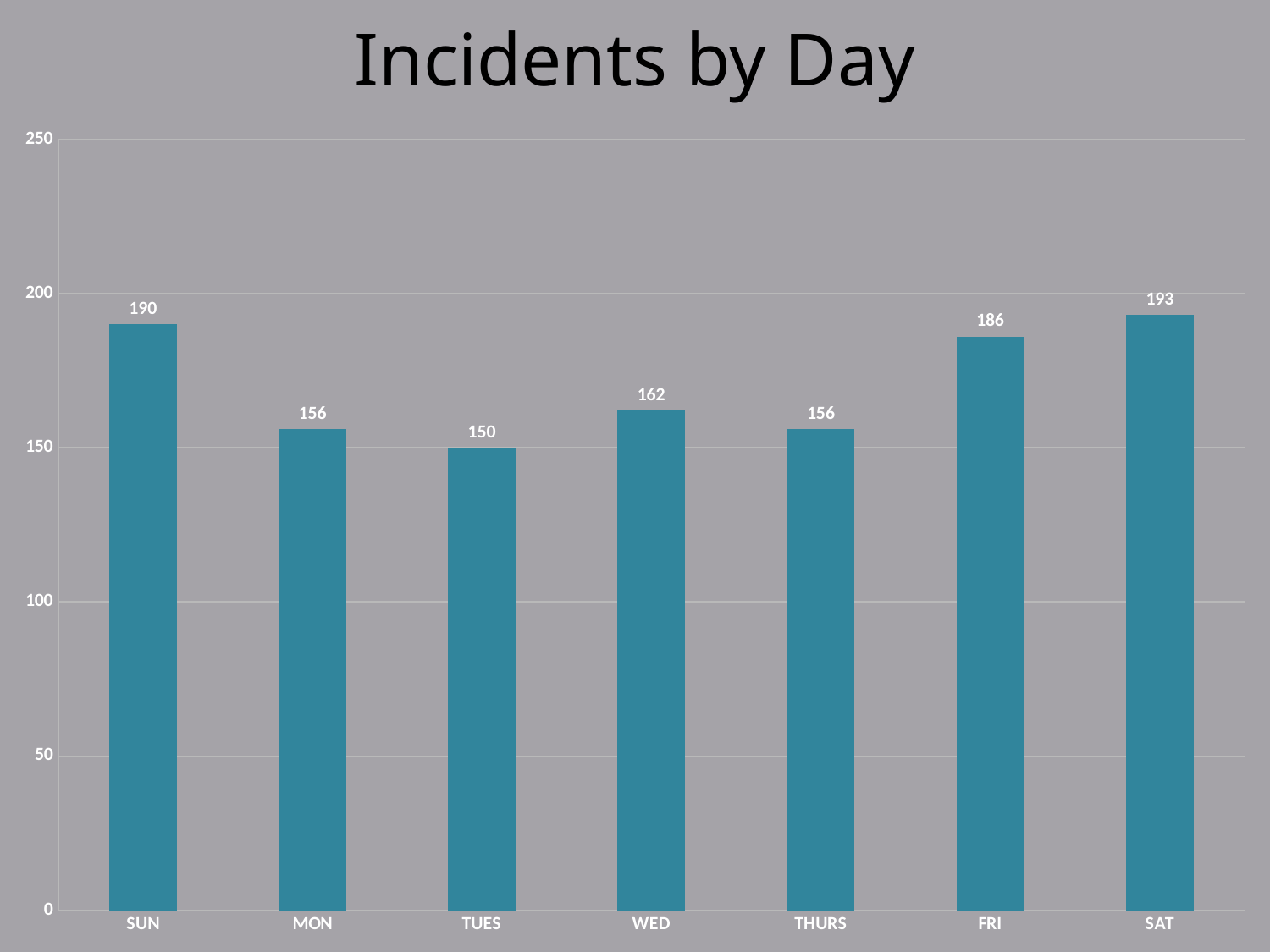
Which is larger, the value for SUN or the value for FRI? SUN What is the value for WED? 162 What is the title of the chart? Incidents by Day What is the value for SUN? 190 How many days are shown on the x axis? 7 Which day has the highest value? SAT What kind of chart is shown on the slide? bar chart Which day has the lowest value? TUES Is the value for TUES greater or less than 200? less What is the difference between the values for SAT and TUES? 43 What is the value for FRI? 186 What is the difference between the values for SUN and MON? 34